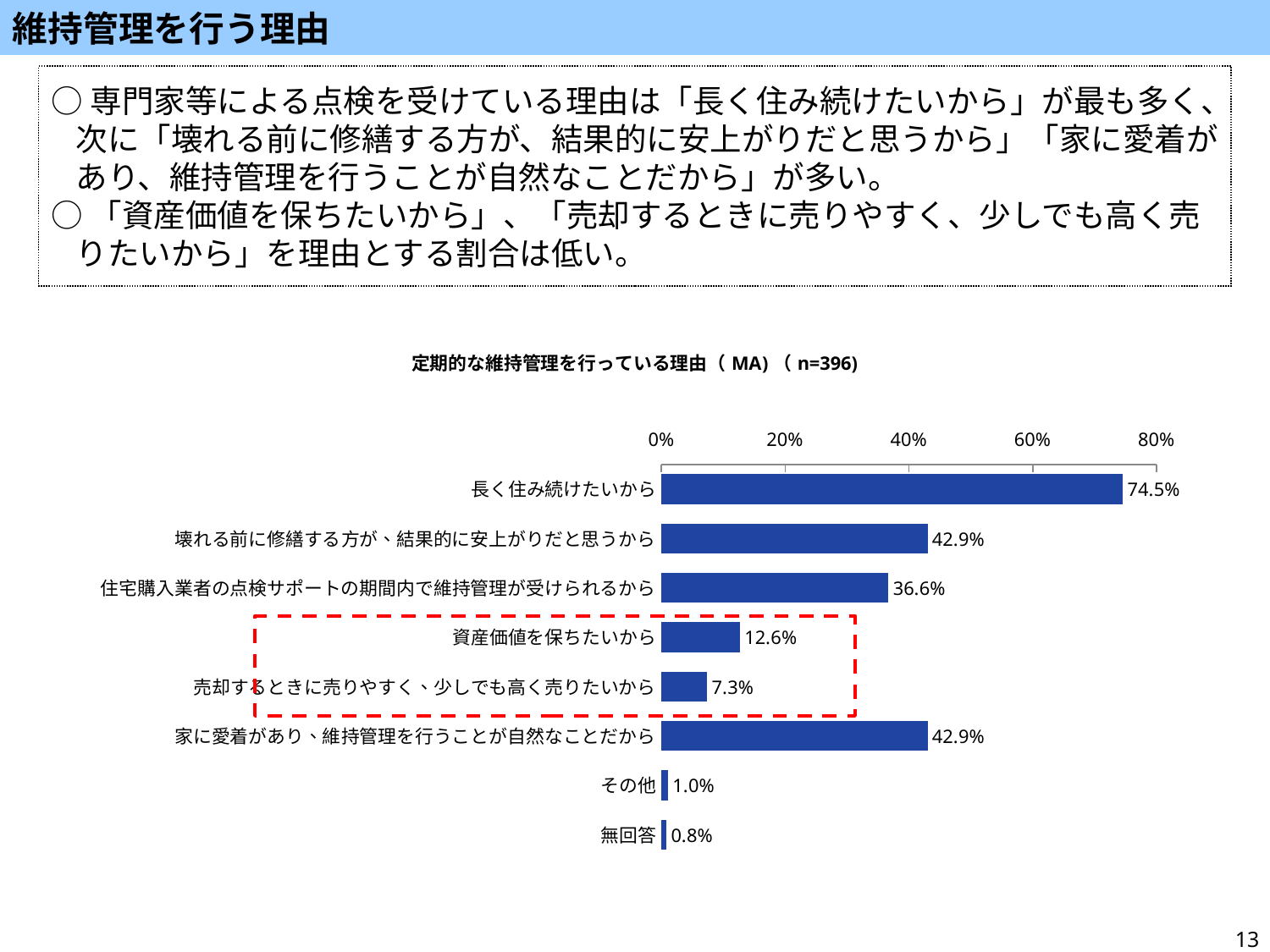
What is the sample size (n) stated in the chart title? 396 Is the value for 長く住み続けたいから greater or less than 60%? greater How many categories are shown in the chart? 8 What kind of chart is shown on the slide? Bar chart Which category has the lowest value? 無回答 What is the value for 住宅購入業者の点検サポートの期間内で維持管理が受けられるから? 36.6% What is the value for 売却するときに売りやすく、少しでも高く売りたいから? 7.3% Which category has the highest value? 長く住み続けたいから What is the value for 資産価値を保ちたいから? 12.6% Which is larger: 資産価値を保ちたいから or 売却するときに売りやすく、少しでも高く売りたいから? 資産価値を保ちたいから What is the value for 長く住み続けたいから? 74.5% What is the difference between 長く住み続けたいから and 壊れる前に修繕する方が、結果的に安上がりだと思うから? 31.6%